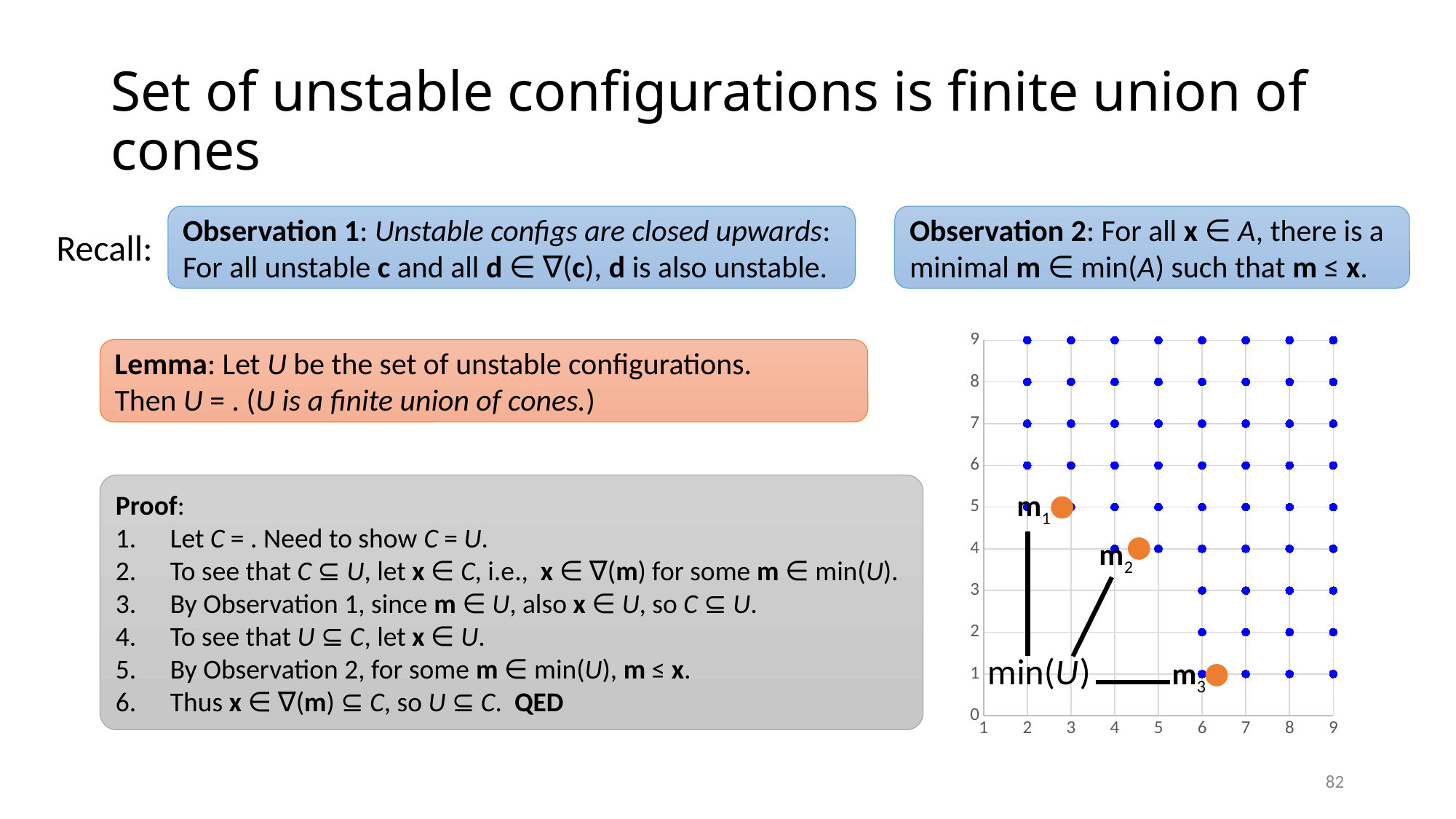
Which labeled point on the chart has the lowest vertical (y) position? m3 Which labeled point is positioned further to the right on the chart, m1 or m3? m3 What is the lowest value shown on the chart's x axis? 1 Which labeled point on the chart has the highest vertical (y) position? m1 Is the vertical (y) position of m2 greater or less than 3? greater Which labeled point is higher on the chart, m2 or m3? m2 What label is written near the bottom-left of the chart, connected by lines to the orange points? min(U) Is the horizontal (x) position of m3 greater or less than 5? greater How many orange labeled points (m points) are marked on the chart? 3 Is the vertical (y) position of m3 greater or less than 2? less What kind of chart is shown on the right of the slide? scatter chart What is the highest value shown on the chart's y axis? 9